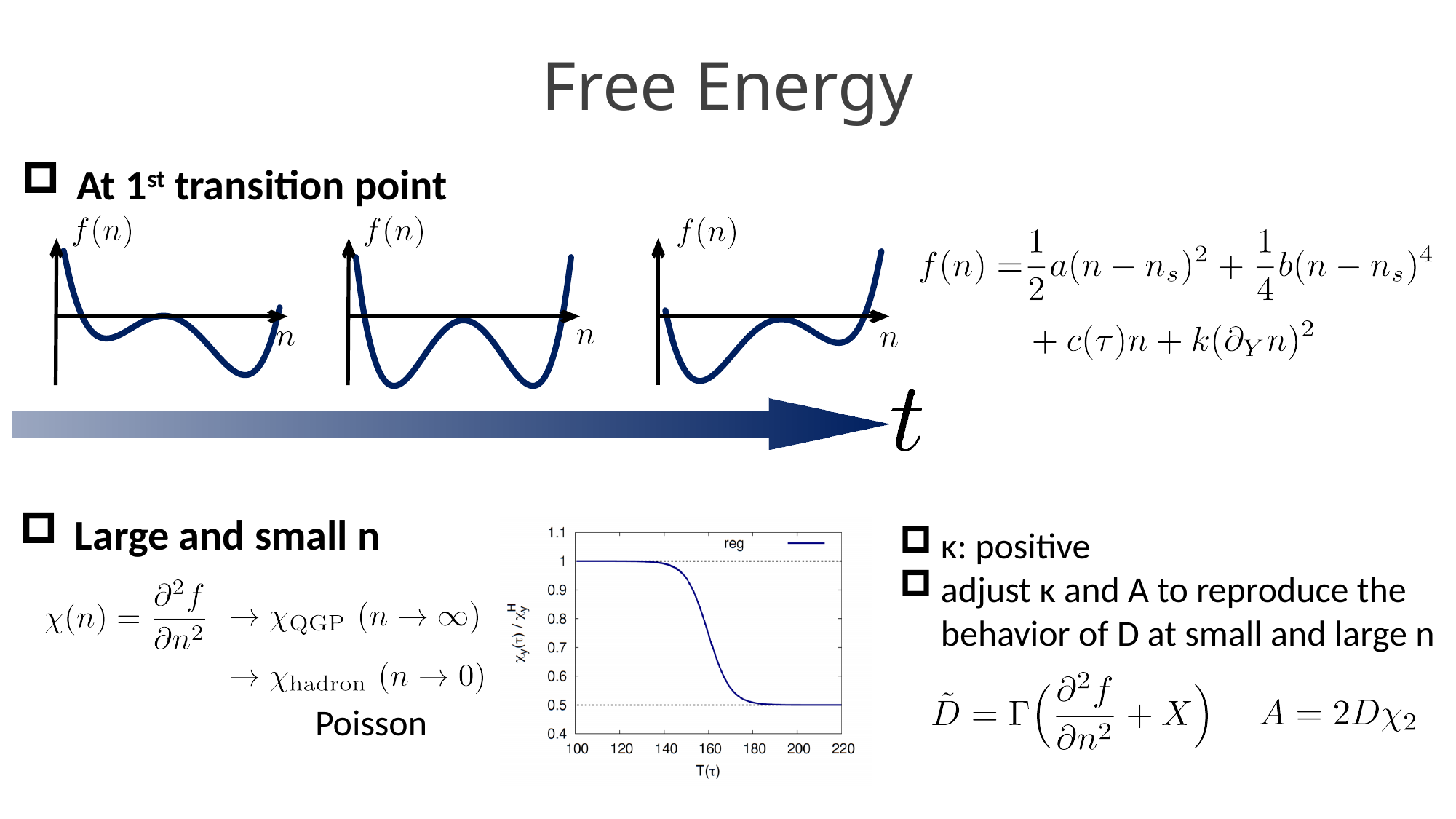
In the bottom-centre chart, what value does the curve take at T(τ) = 100? 1 How many tick labels are shown on the x axis of the bottom-centre chart? 7 In the bottom-centre chart, which is larger: the value at T(τ) = 120 or at T(τ) = 200? T(τ) = 120 What is the legend entry in the bottom-centre chart? reg In the bottom-centre chart, is the value at T(τ) = 200 greater or less than 0.6? less In the bottom-centre chart, what value does the curve take at T(τ) = 220? 0.5 In the bottom-centre chart, is the value at T(τ) = 160 greater or less than 0.5? greater What is the x-axis label of the bottom-centre chart? T(τ) In the bottom-centre chart, does the plotted value rise or fall as T(τ) increases? fall How many series does the legend of the bottom-centre chart list? 1 In the bottom-centre chart, is the value at T(τ) = 120 greater or less than 0.9? greater What kind of chart is the plot at the bottom centre of the slide? line chart